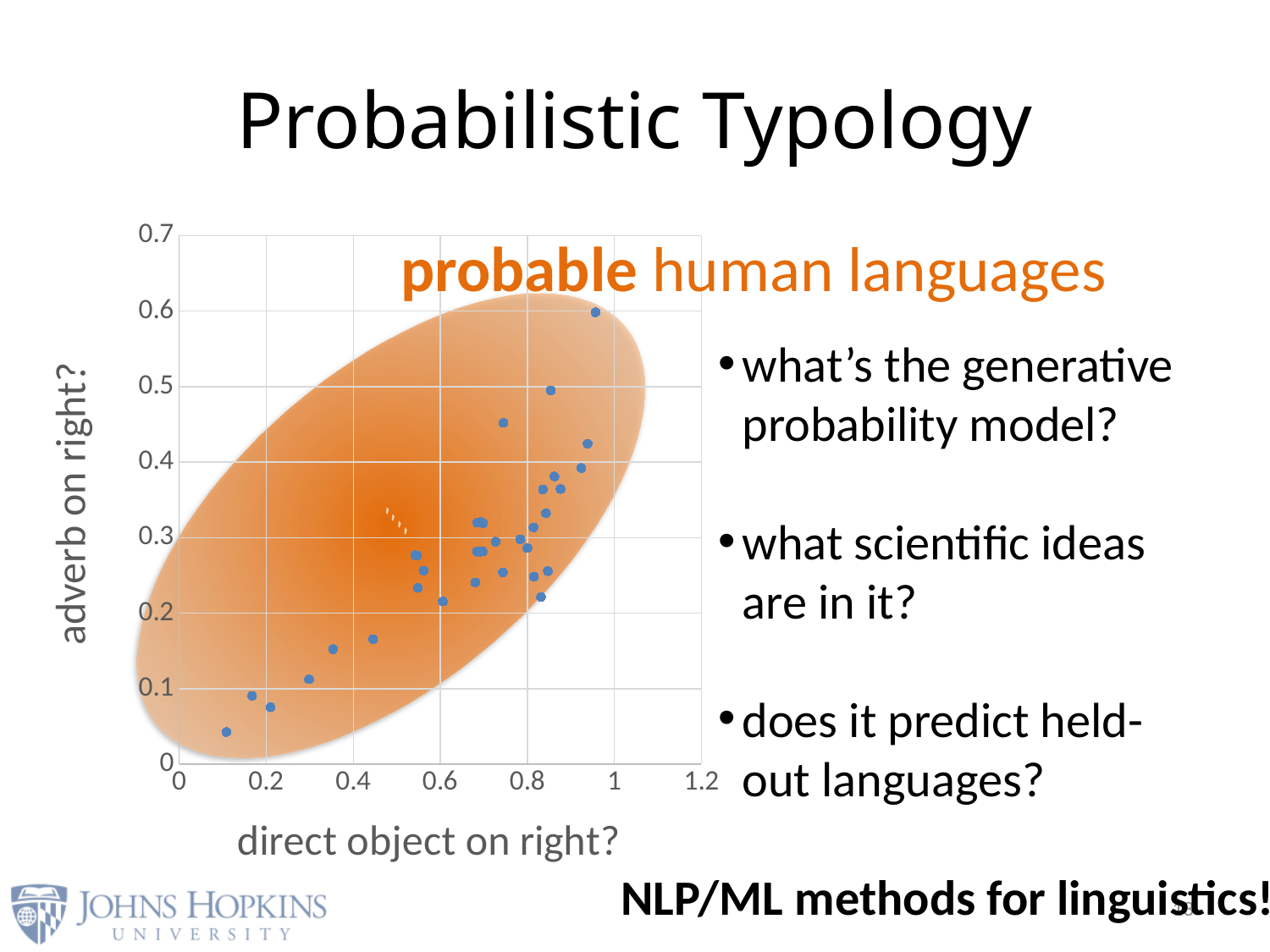
What kind of chart is shown on the slide? scatter plot What is the label of the y axis of the chart? adverb on right? Are there any points in the chart with an x value greater than 1.2? no As the x value (direct object on right?) increases, do the y values (adverb on right?) of the points generally rise or fall? rise Is the y value of the lowest point in the chart greater or less than 0.1? less Is the y value of the highest point in the chart greater or less than 0.5? greater What is the label of the x axis of the chart? direct object on right?